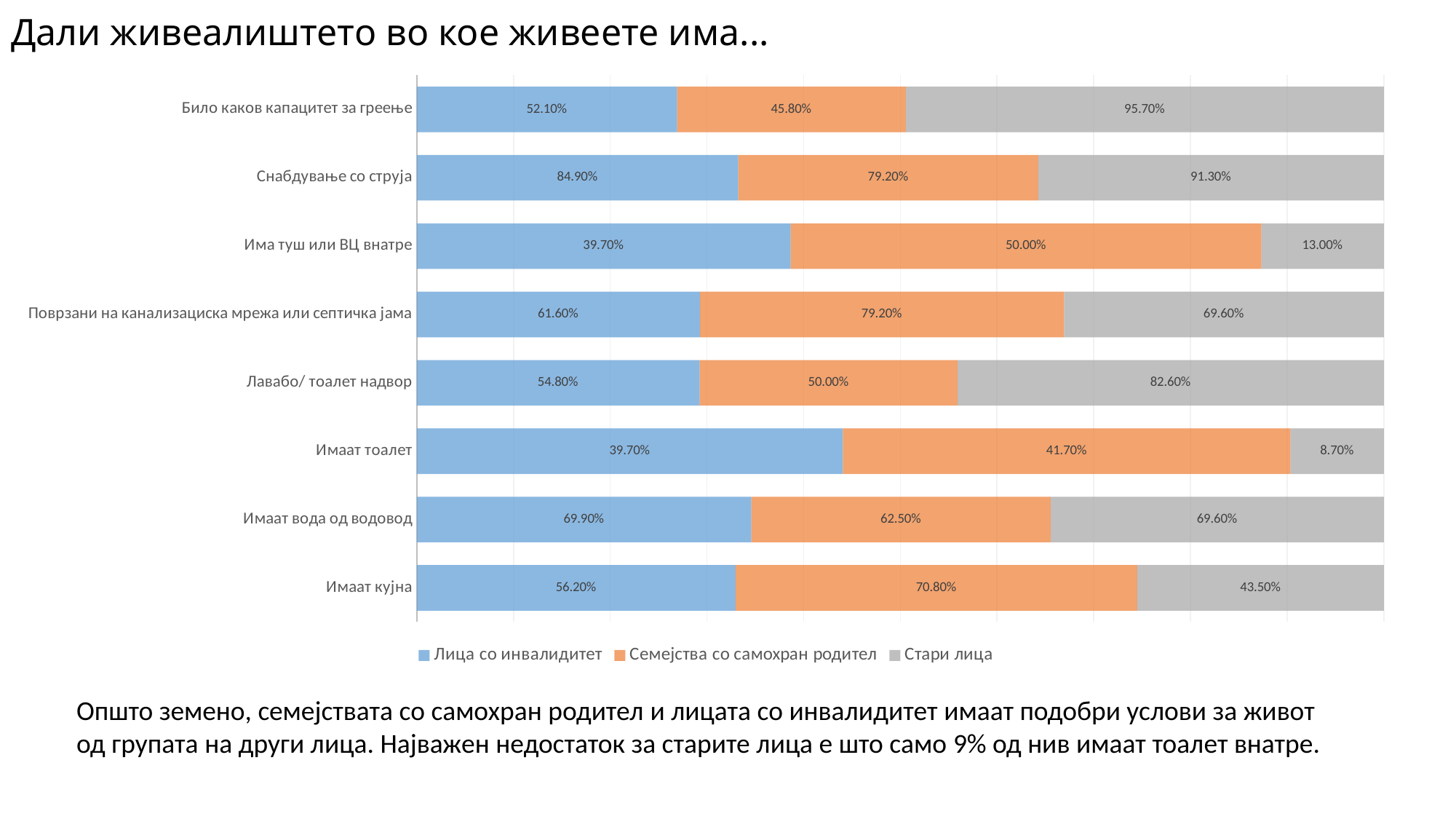
In which category is the value for Лица со инвалидитет the highest? Снабдување со струја What is the value for Стари лица in the category Било каков капацитет за греење? 95.70% What is the value for Лица со инвалидитет in the category Снабдување со струја? 84.90% What is the value for Стари лица in the category Има туш или ВЦ внатре? 13.00% Which colour represents the series Стари лица in the chart? Grey Which is larger in the category Имаат кујна: the value for Семејства со самохран родител or the value for Стари лица? Семејства со самохран родител What is the difference between the Стари лица value and the Лица со инвалидитет value in the category Лавабо/ тоалет надвор? 27.80% How many series does the legend list? 3 What is the value for Семејства со самохран родител in the category Имаат кујна? 70.80% In which category is the value for Стари лица the lowest? Имаат тоалет What kind of chart is shown on the slide? Stacked bar chart How many categories are shown on the chart? 8